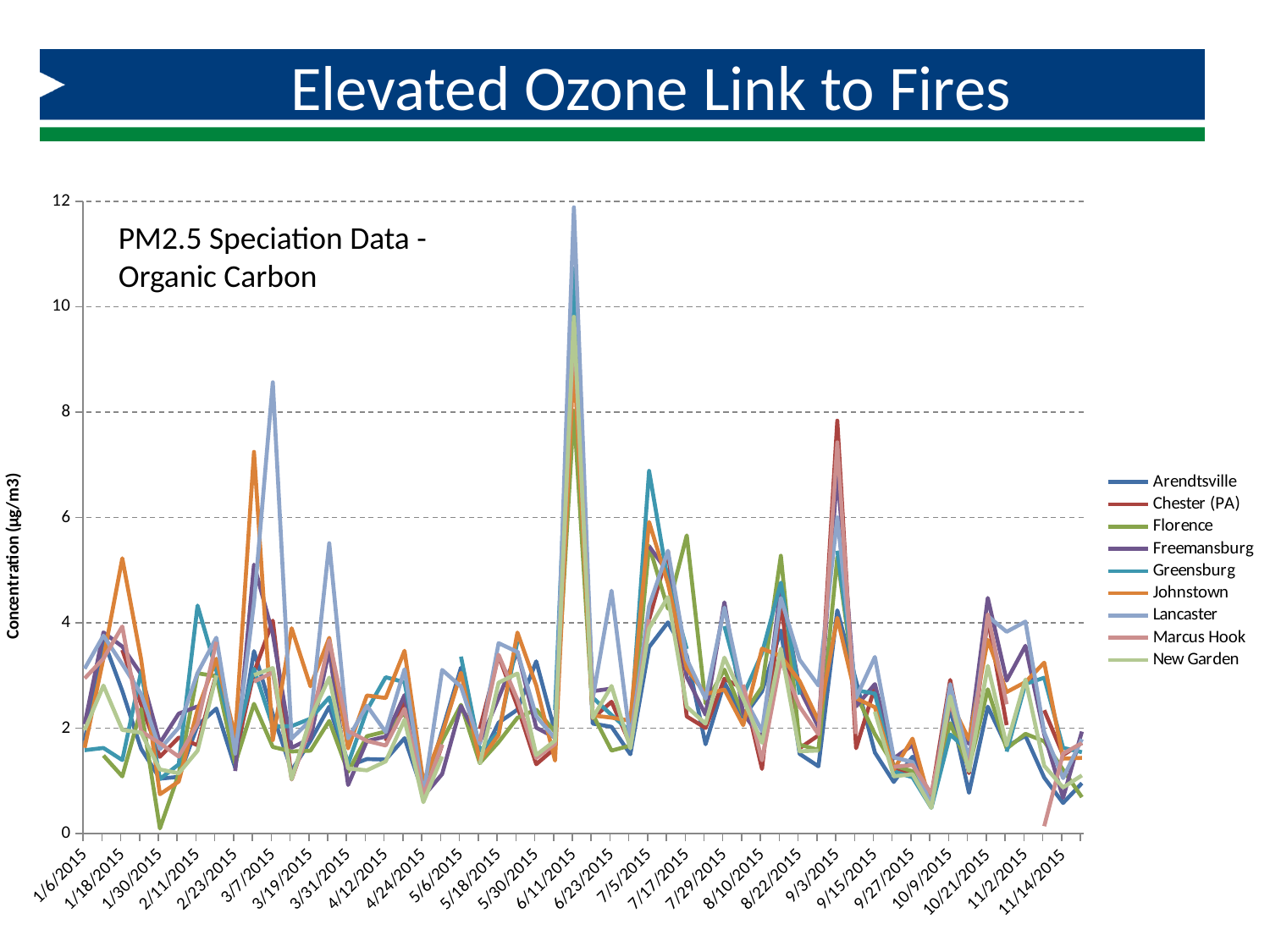
Is the peak value for Lancaster near 6/11/2015 greater or less than 10? greater How many series does the legend list? 9 What is the title text shown inside the chart? PM2.5 Speciation Data - Organic Carbon What is the highest value shown on the vertical axis? 12 Is the value for Florence near 1/30/2015 greater or less than 1? less Is the peak value for Chester (PA) near 9/3/2015 greater or less than 6? greater What is the label on the vertical axis of the chart? Concentration (µg/m3) Which series reaches the highest value anywhere on the chart? Lancaster What kind of chart is shown on the slide? line chart What is the first date label on the horizontal axis? 1/6/2015 What is the last date label on the horizontal axis? 11/14/2015